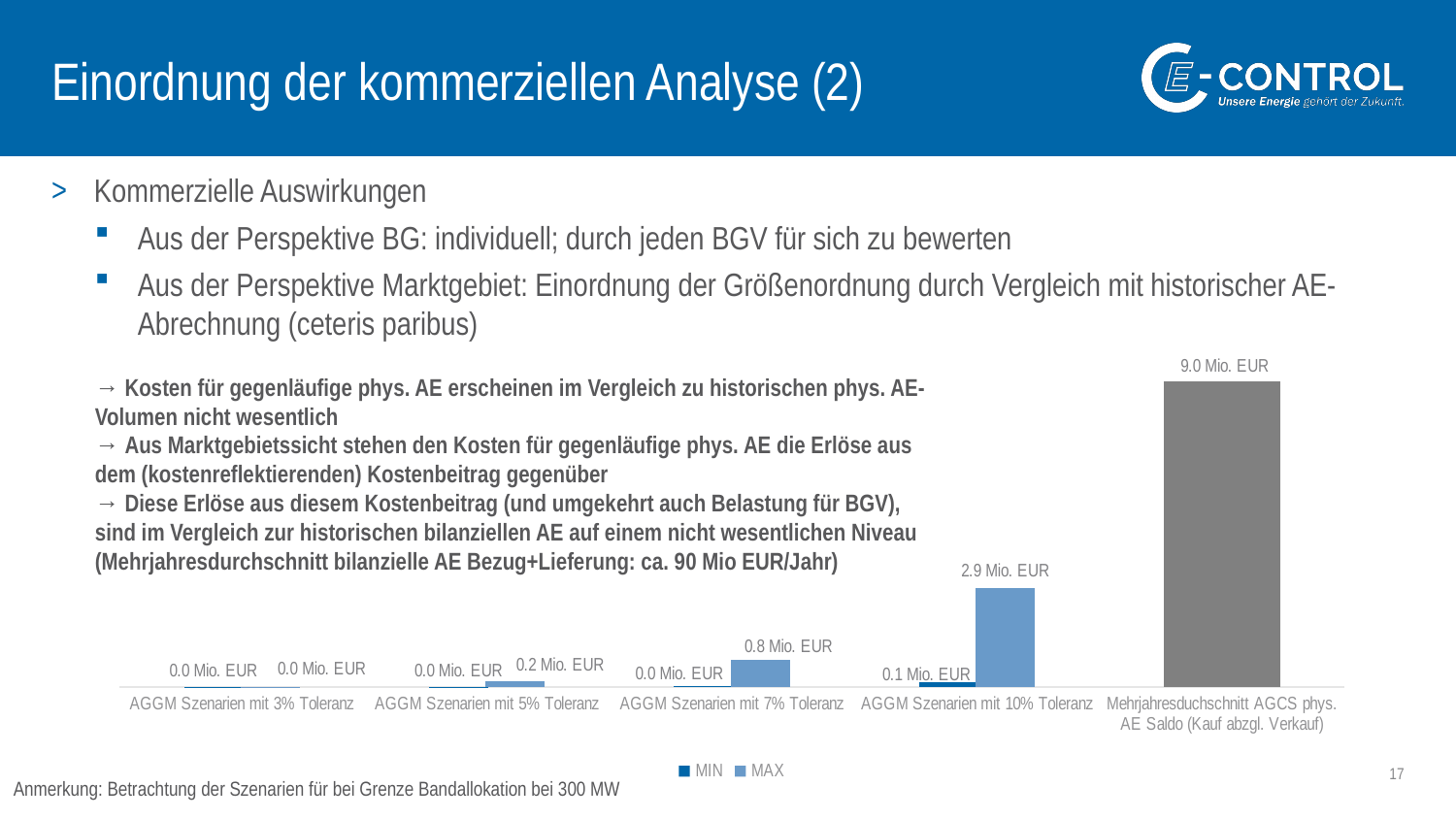
What is the MAX value for AGGM Szenarien mit 7% Toleranz? 0.8 Mio. EUR What value is shown for Mehrjahresduchschnitt AGCS phys. AE Saldo (Kauf abzgl. Verkauf)? 9.0 Mio. EUR What kind of chart is shown on the slide? bar chart How many series does the legend list? 2 Which is larger: the MAX value for AGGM Szenarien mit 7% Toleranz or the MAX value for AGGM Szenarien mit 5% Toleranz? AGGM Szenarien mit 7% Toleranz What is the difference between the MAX value for AGGM Szenarien mit 10% Toleranz and the MAX value for AGGM Szenarien mit 7% Toleranz? 2.1 Mio. EUR What is the MIN value for AGGM Szenarien mit 10% Toleranz? 0.1 Mio. EUR Which category has the highest value in the chart? Mehrjahresduchschnitt AGCS phys. AE Saldo (Kauf abzgl. Verkauf) How many categories are shown on the x axis? 5 What is the MAX value for AGGM Szenarien mit 5% Toleranz? 0.2 Mio. EUR What are the series names in the legend? MIN, MAX What is the MAX value for AGGM Szenarien mit 10% Toleranz? 2.9 Mio. EUR